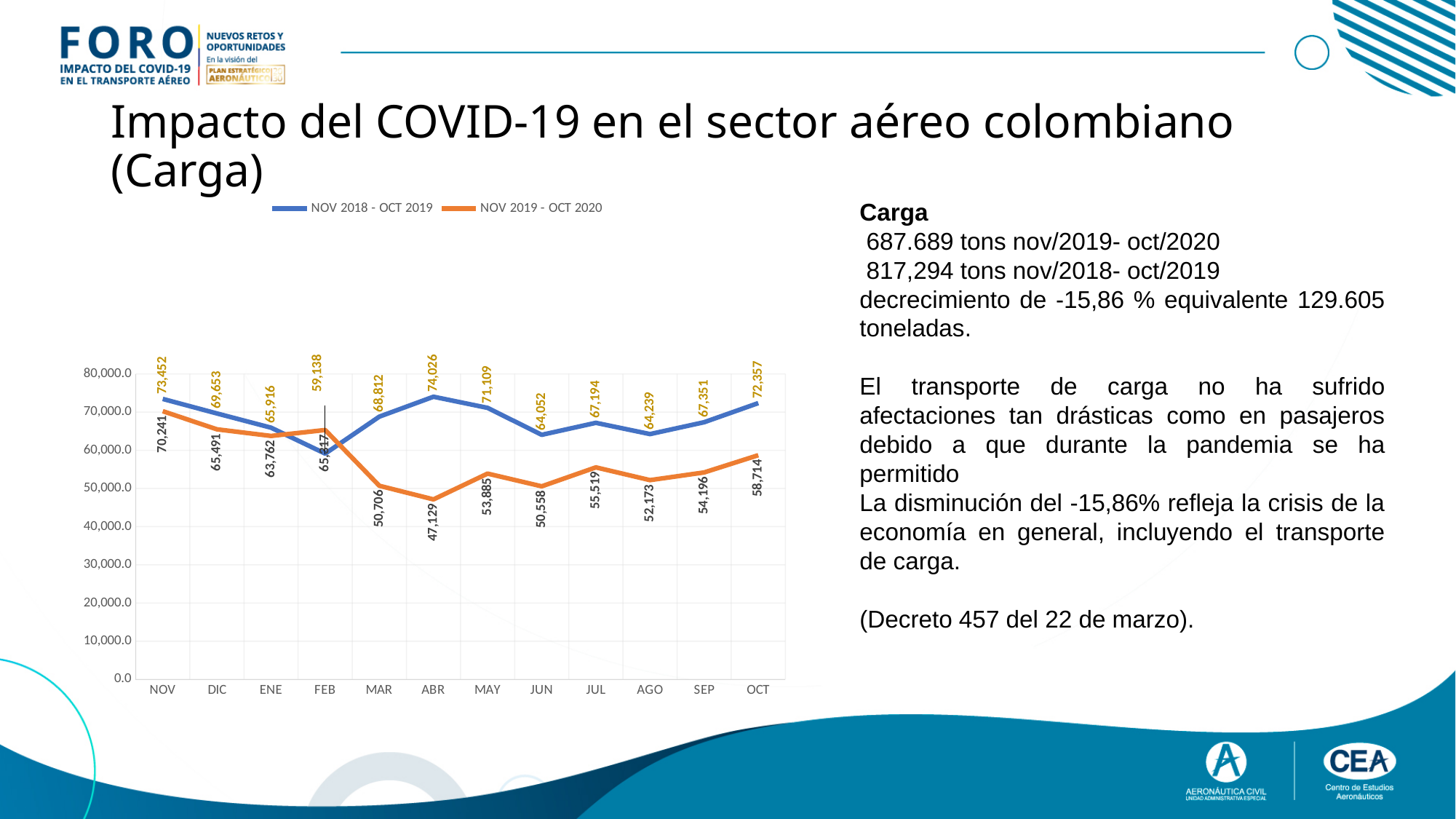
In which month does the NOV 2018 - OCT 2019 series reach its lowest value? FEB What is the difference between the NOV 2018 - OCT 2019 and NOV 2019 - OCT 2020 values in ABR? 26,897 What is the value for the NOV 2019 - OCT 2020 series in ABR? 47,129 What is the value for the NOV 2019 - OCT 2020 series in OCT? 58,714 In FEB, which series has the higher value? NOV 2019 - OCT 2020 In which month does the NOV 2019 - OCT 2020 series reach its lowest value? ABR How many series does the legend list? 2 How many months are plotted along the x axis? 12 Is the value for the NOV 2019 - OCT 2020 series in MAR greater or less than 60,000? less In which month does the NOV 2018 - OCT 2019 series reach its highest value? ABR What kind of chart is shown on the slide? line chart What is the value for the NOV 2018 - OCT 2019 series in ABR? 74,026